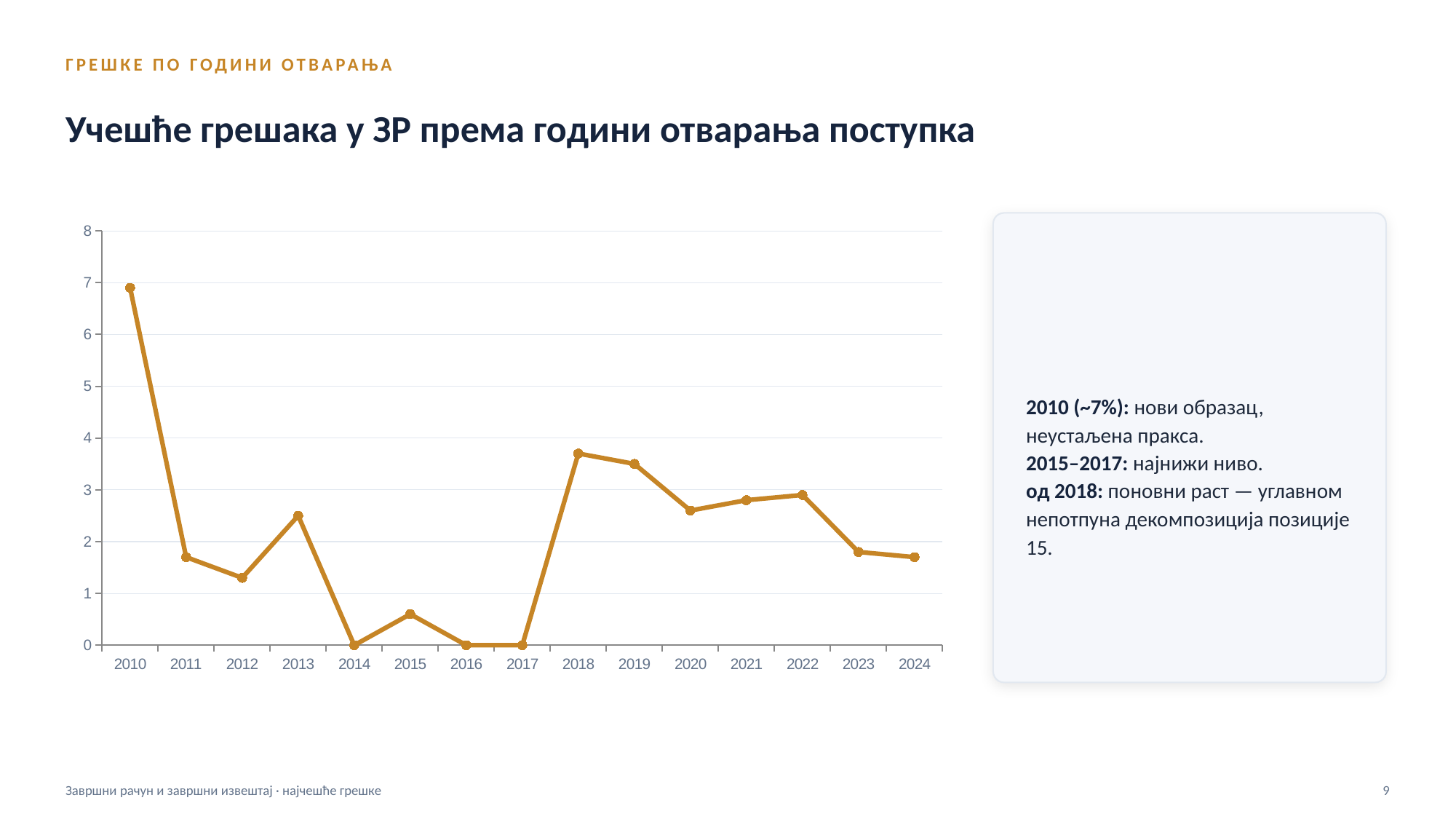
Do the values rise or fall from 2022 to 2024? fall Is the value for 2010 greater or less than 6? greater How many years are plotted on the x axis of the chart? 15 What kind of chart is shown on the slide? line chart Do the values rise or fall from 2010 to 2012? fall Which year has the highest value on the chart? 2010 Which is larger, the value for 2013 or the value for 2018? 2018 What is the value for 2017? 0 What is the title of the chart on the slide? Учешће грешака у ЗР према години отварања поступка Is the value for 2012 greater or less than 2? less What is the value for 2014? 0 Is the value for 2018 greater or less than 3? greater